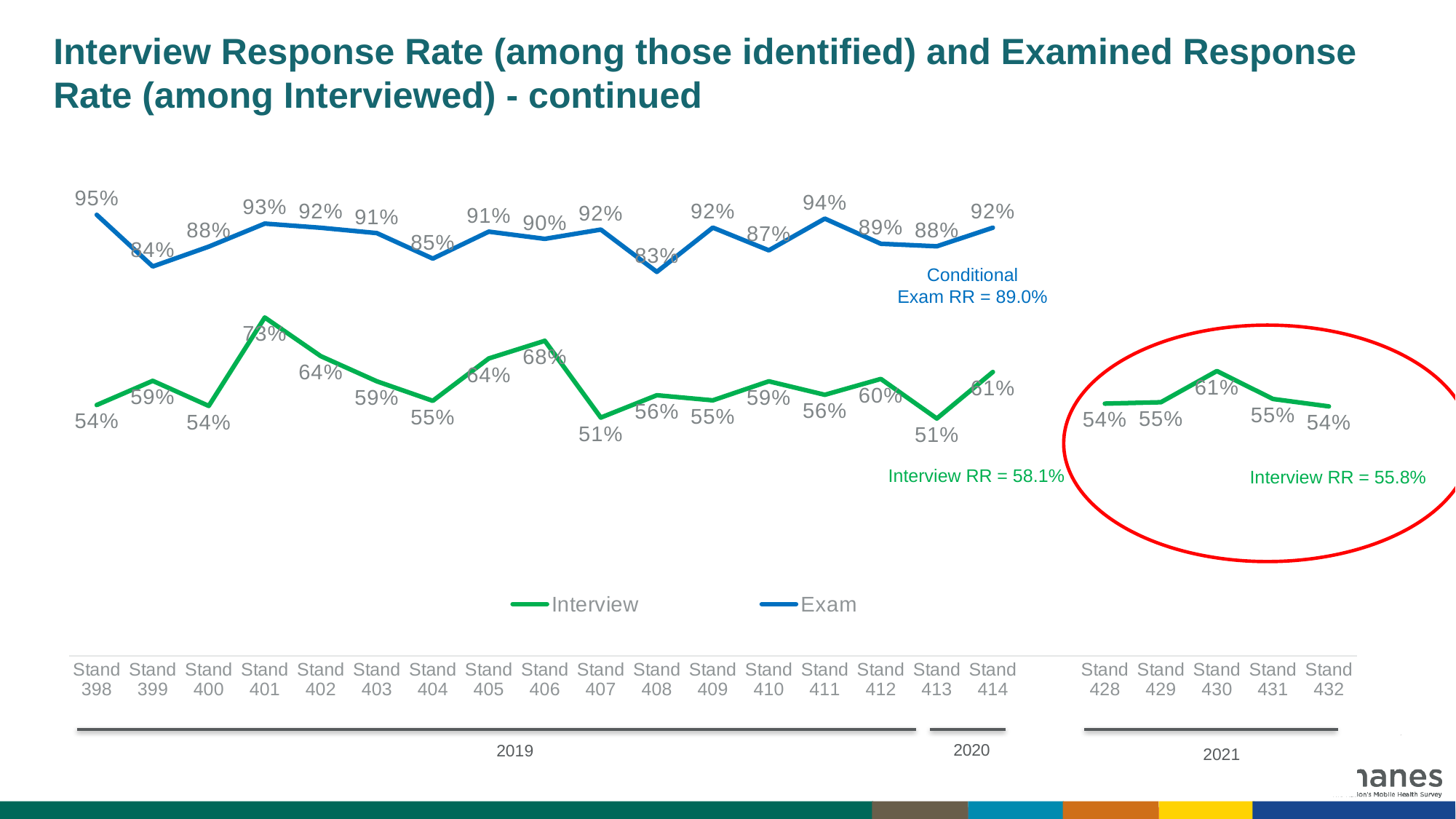
What kind of chart is shown on the slide? Line chart What is the Exam response rate at Stand 398? 95% Which has the higher Interview response rate, Stand 406 or Stand 407? Stand 406 At which stand is the Interview response rate highest? Stand 401 At which stand is the Exam response rate lowest? Stand 408 What is the Exam response rate at Stand 411? 94% What Interview RR is annotated for the circled 2021 stands? 55.8% How many series does the legend list? 2 What is the Interview response rate at Stand 401? 73% What is the Interview response rate at Stand 430? 61% What is the difference between the Exam and Interview response rates at Stand 398? 41 percentage points At which stand is the Exam response rate highest? Stand 398